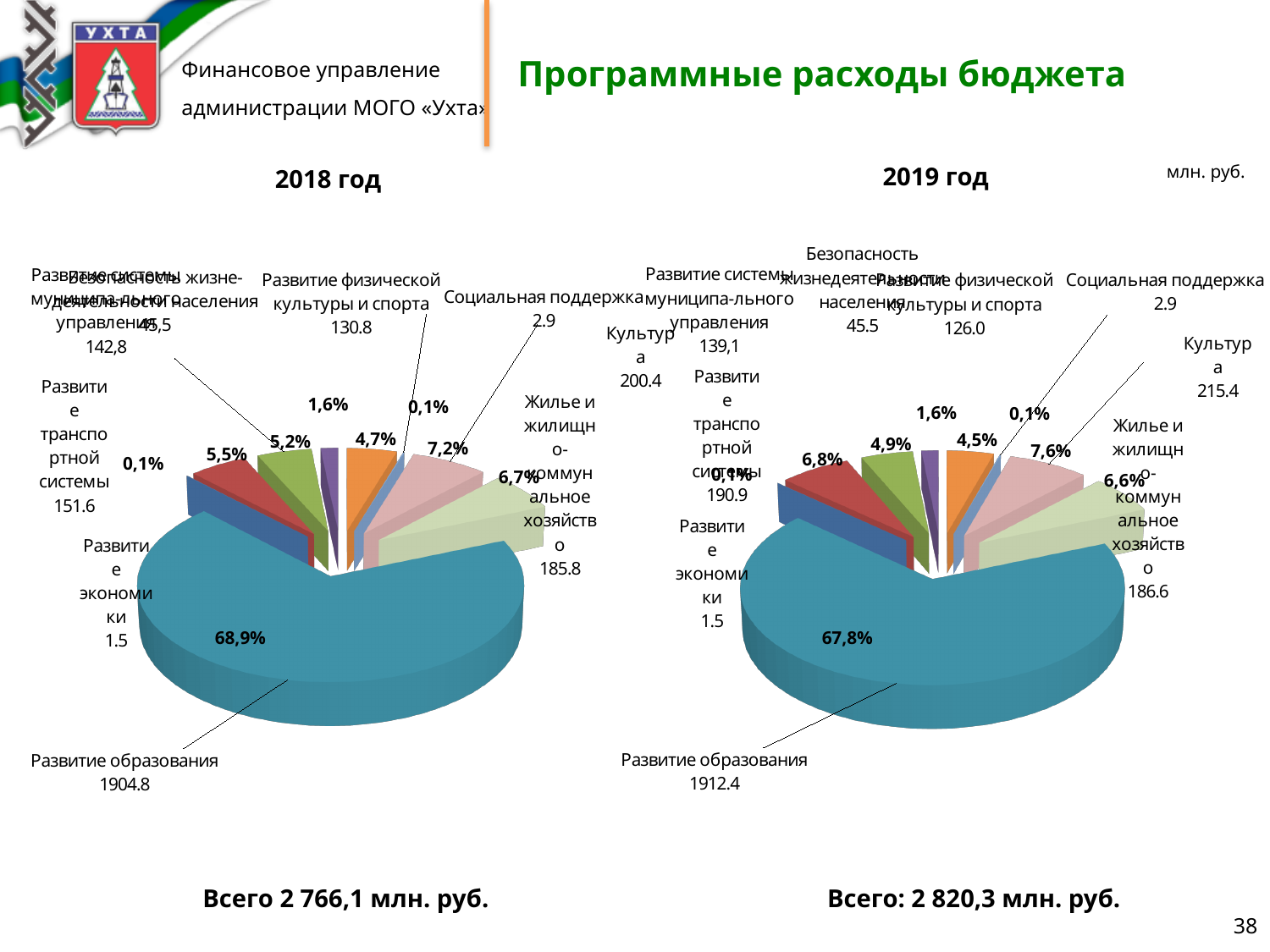
What kind of chart is used for the 2018 год data? Pie chart On the 2019 год chart, what share of the pie does Развитие образования take? 67,8% On the 2018 год chart, what is the difference between Развитие транспортной системы (151.6) and Развитие физической культуры и спорта (130.8)? 20.8 On the 2018 год chart, what share of the pie does Культура take? 7,2% On the 2019 год chart, what value is shown for Социальная поддержка? 2.9 On the 2019 год chart, which category has the largest slice? Развитие образования On the 2018 год chart, which category has the largest value? Развитие образования On the 2019 год chart, what value is shown for Развитие транспортной системы? 190.9 What total is stated below the 2019 год chart? 2 820,3 млн. руб. On the 2019 год chart, which is larger: Культура or Жилье и жилищно-коммунальное хозяйство? Культура On the 2019 год chart, what value is shown for Культура? 215.4 On the 2018 год chart, what value is shown for Развитие образования? 1904.8